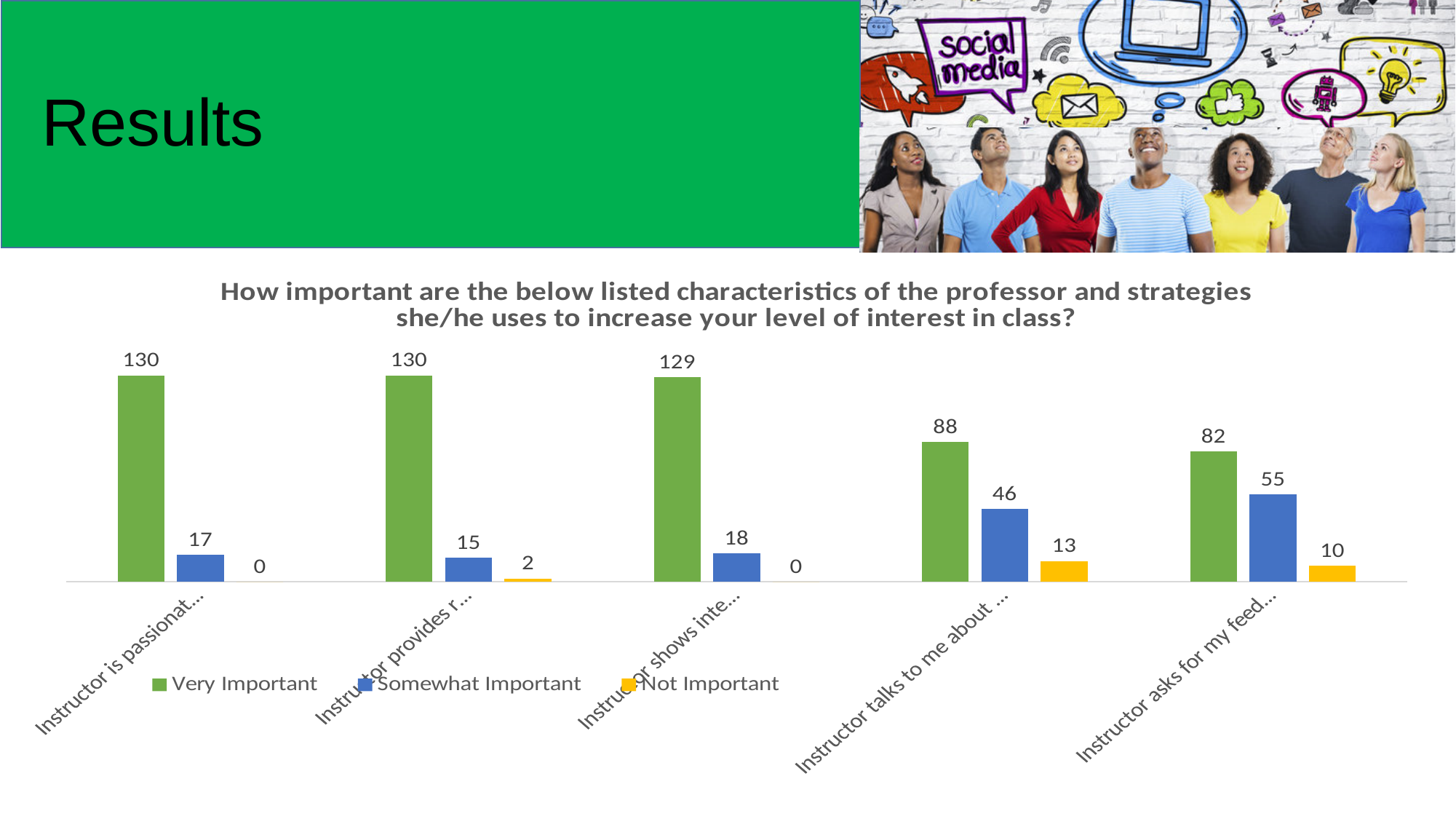
Which colour represents the 'Not Important' series in the legend? yellow What is the 'Very Important' value for the category 'Instructor talks to me about ...'? 88 Which is larger: the 'Not Important' value for 'Instructor talks to me about ...' or for 'Instructor asks for my feed...'? Instructor talks to me about ... Which category has the lowest 'Very Important' value? Instructor asks for my feed... What is the difference between the 'Very Important' and 'Somewhat Important' values for the category 'Instructor talks to me about ...'? 42 Which category has the highest 'Somewhat Important' value? Instructor asks for my feed... What is the 'Not Important' value for the category 'Instructor provides r...'? 2 How many series does the legend list? 3 How many categories are plotted along the x axis? 5 What is the total of the three values for the category 'Instructor shows inte...'? 147 What is the 'Somewhat Important' value for the category 'Instructor asks for my feed...'? 55 What type of chart is shown on the slide? bar chart